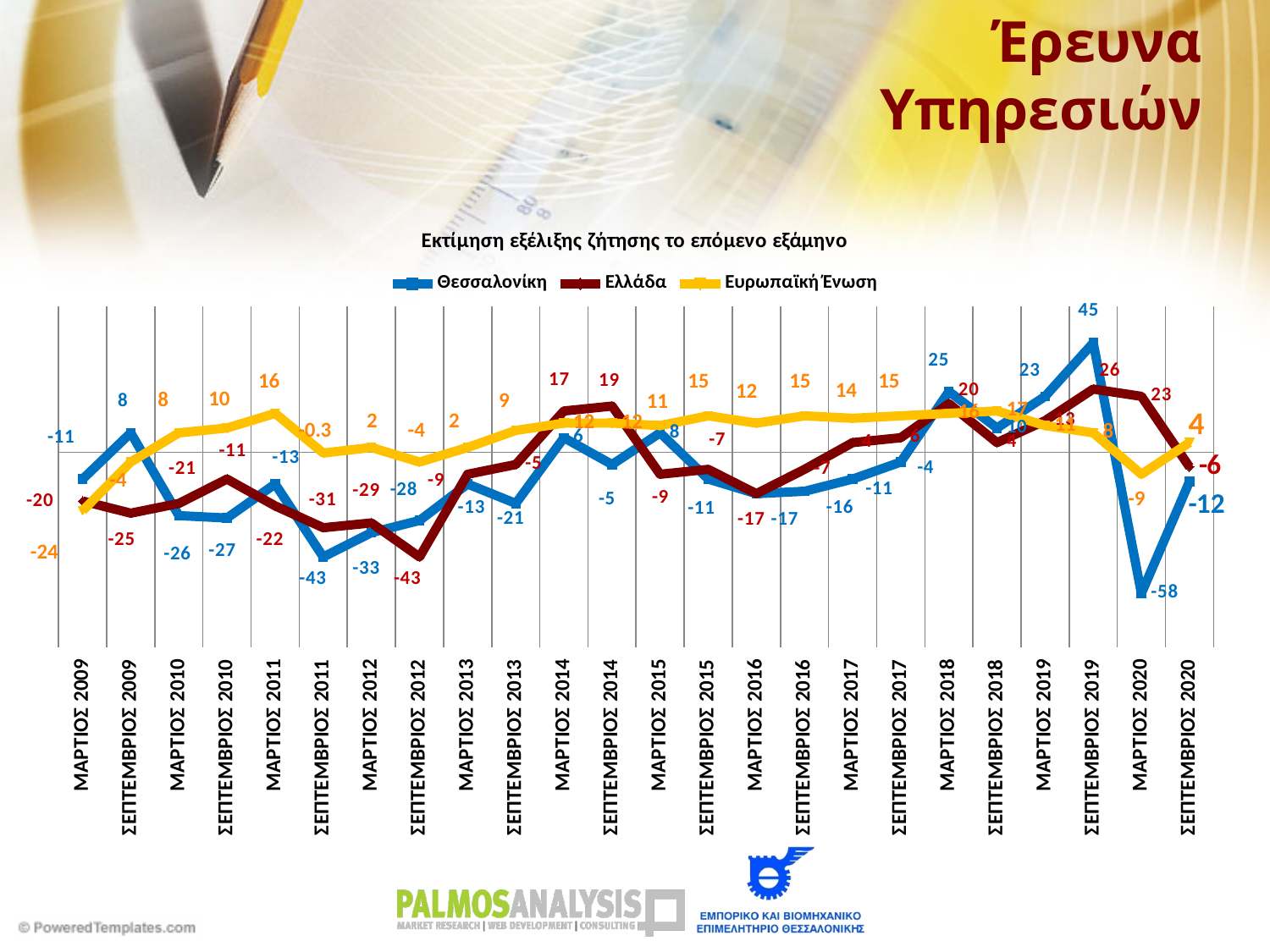
What is the value for Ευρωπαϊκή Ένωση in ΣΕΠΤΕΜΒΡΙΟΣ 2011? -0.3 What is the value for Ελλάδα in ΣΕΠΤΕΜΒΡΙΟΣ 2012? -43 In ΜΑΡΤΙΟΣ 2020, which is larger: the value for Ελλάδα or for Ευρωπαϊκή Ένωση? Ελλάδα What type of chart is shown on the slide? line chart What is the value for Θεσσαλονίκη in ΣΕΠΤΕΜΒΡΙΟΣ 2019? 45 How many series does the legend list? 3 How many time points are plotted along the x axis? 24 In which period does Ελλάδα reach its highest value? ΣΕΠΤΕΜΒΡΙΟΣ 2019 What is the title of the chart? Εκτίμηση εξέλιξης ζήτησης το επόμενο εξάμηνο In which period does Θεσσαλονίκη reach its lowest value? ΜΑΡΤΙΟΣ 2020 What is the difference between the Ελλάδα and Θεσσαλονίκη values in ΣΕΠΤΕΜΒΡΙΟΣ 2020? 6 What is the value for Ευρωπαϊκή Ένωση in ΜΑΡΤΙΟΣ 2009? -24